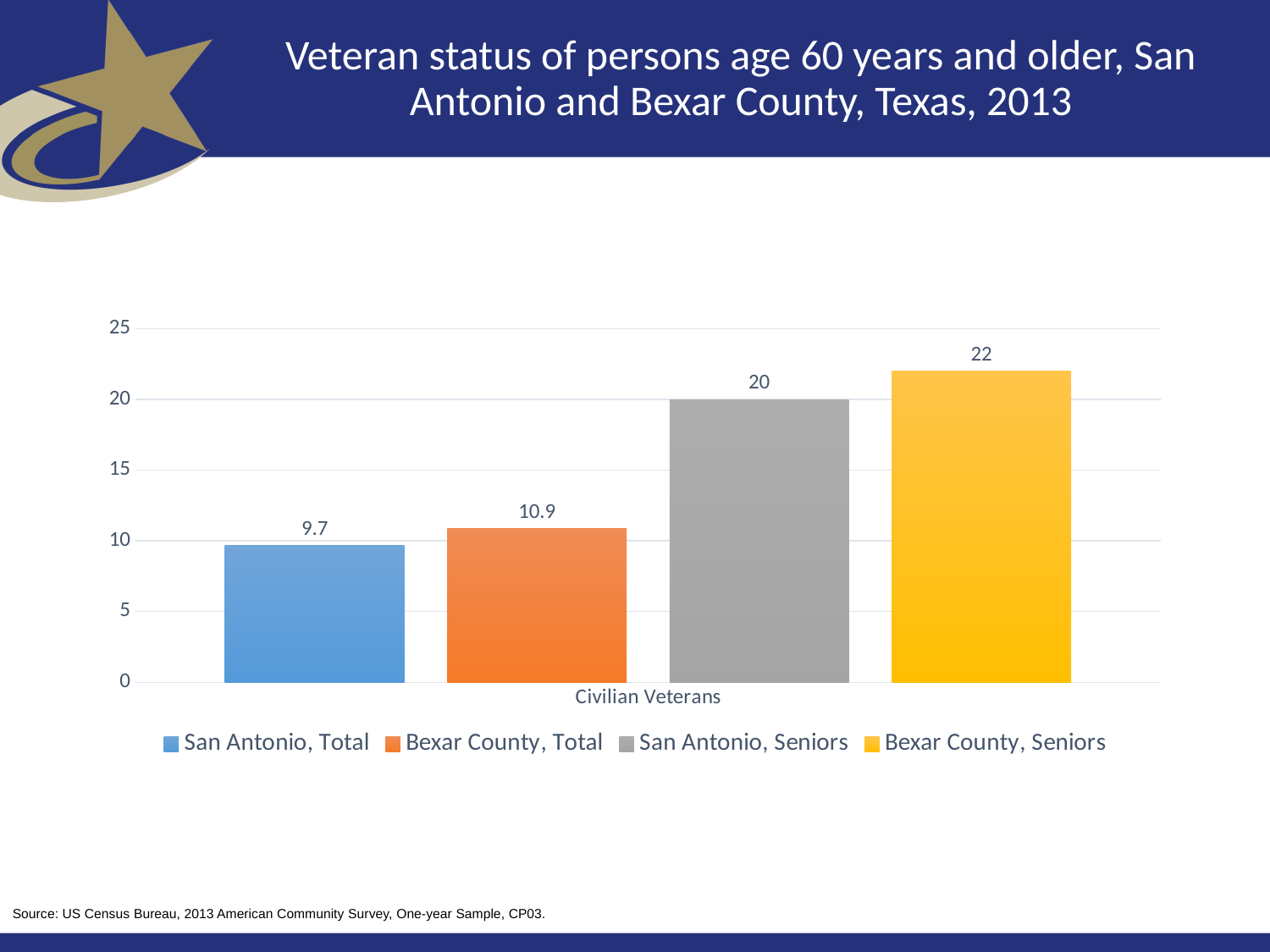
What is the value for San Antonio, Seniors? 20 What is the value for San Antonio, Total? 9.7 What is the value for Bexar County, Seniors? 22 What kind of chart is shown on the slide? bar chart Which series has the highest value? Bexar County, Seniors What is the category label shown on the x axis? Civilian Veterans Which series has the lowest value? San Antonio, Total What is the difference between Bexar County, Total and San Antonio, Total? 1.2 What is the difference between Bexar County, Seniors and San Antonio, Seniors? 2 Which is larger, Bexar County, Total or San Antonio, Total? Bexar County, Total Is the value for Bexar County, Seniors greater or less than 20? greater How many series does the legend list? 4